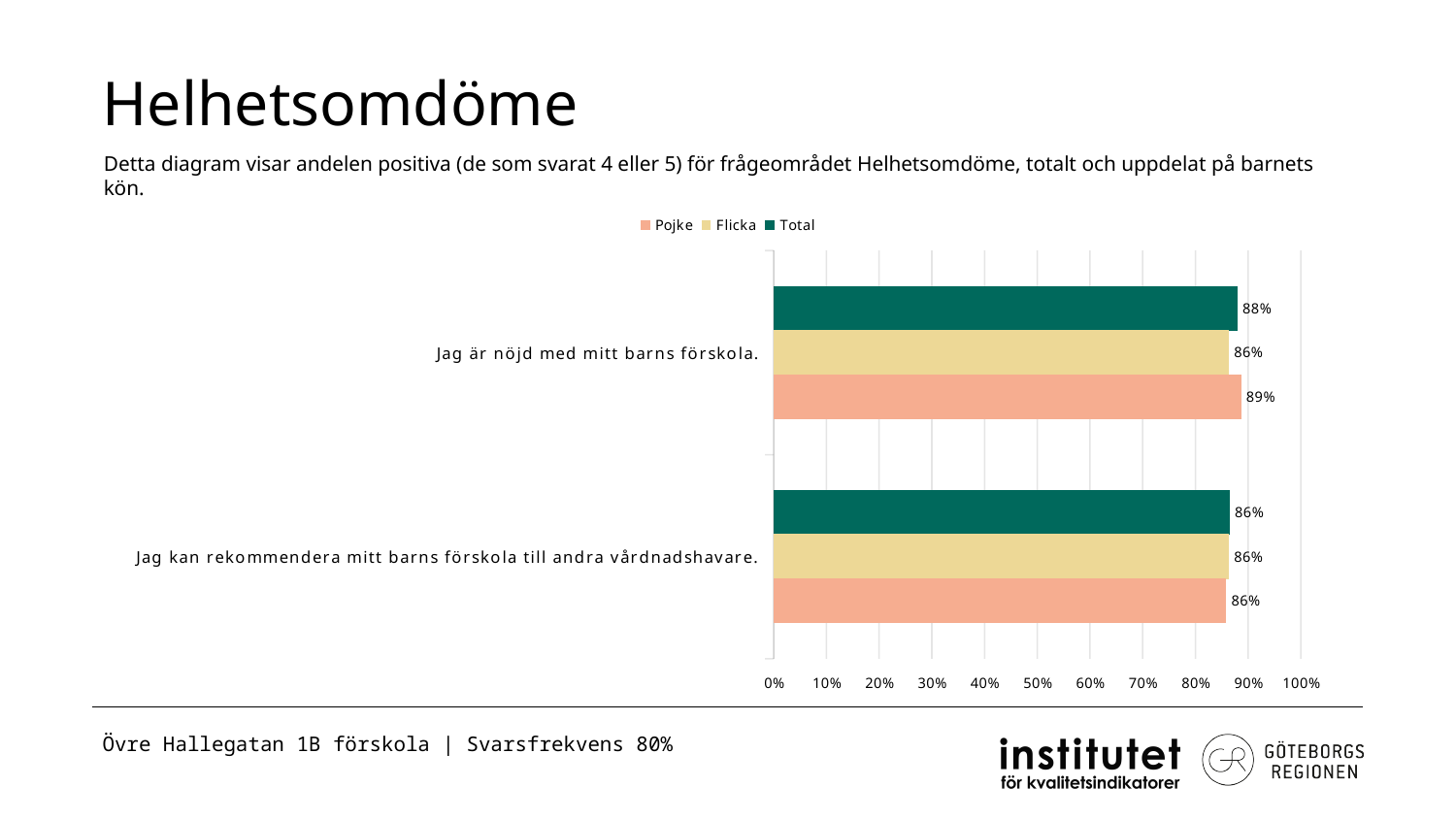
What kind of chart is shown on the slide? Bar chart How many series does the legend list? 3 What is the Total value for "Jag kan rekommendera mitt barns förskola till andra vårdnadshavare."? 86% What is the difference between the Pojke and Flicka values for "Jag är nöjd med mitt barns förskola."? 3 percentage points What is the value for Flicka for "Jag är nöjd med mitt barns förskola."? 86% What is the value for Pojke for "Jag är nöjd med mitt barns förskola."? 89% Which series has the lowest value for "Jag är nöjd med mitt barns förskola."? Flicka What is the Total value for "Jag är nöjd med mitt barns förskola."? 88% Which series has the highest value for "Jag är nöjd med mitt barns förskola."? Pojke How many question categories are shown on the chart? 2 What is the value for Pojke for "Jag kan rekommendera mitt barns förskola till andra vårdnadshavare."? 86% Is the Total value for "Jag är nöjd med mitt barns förskola." greater or less than 80%? greater